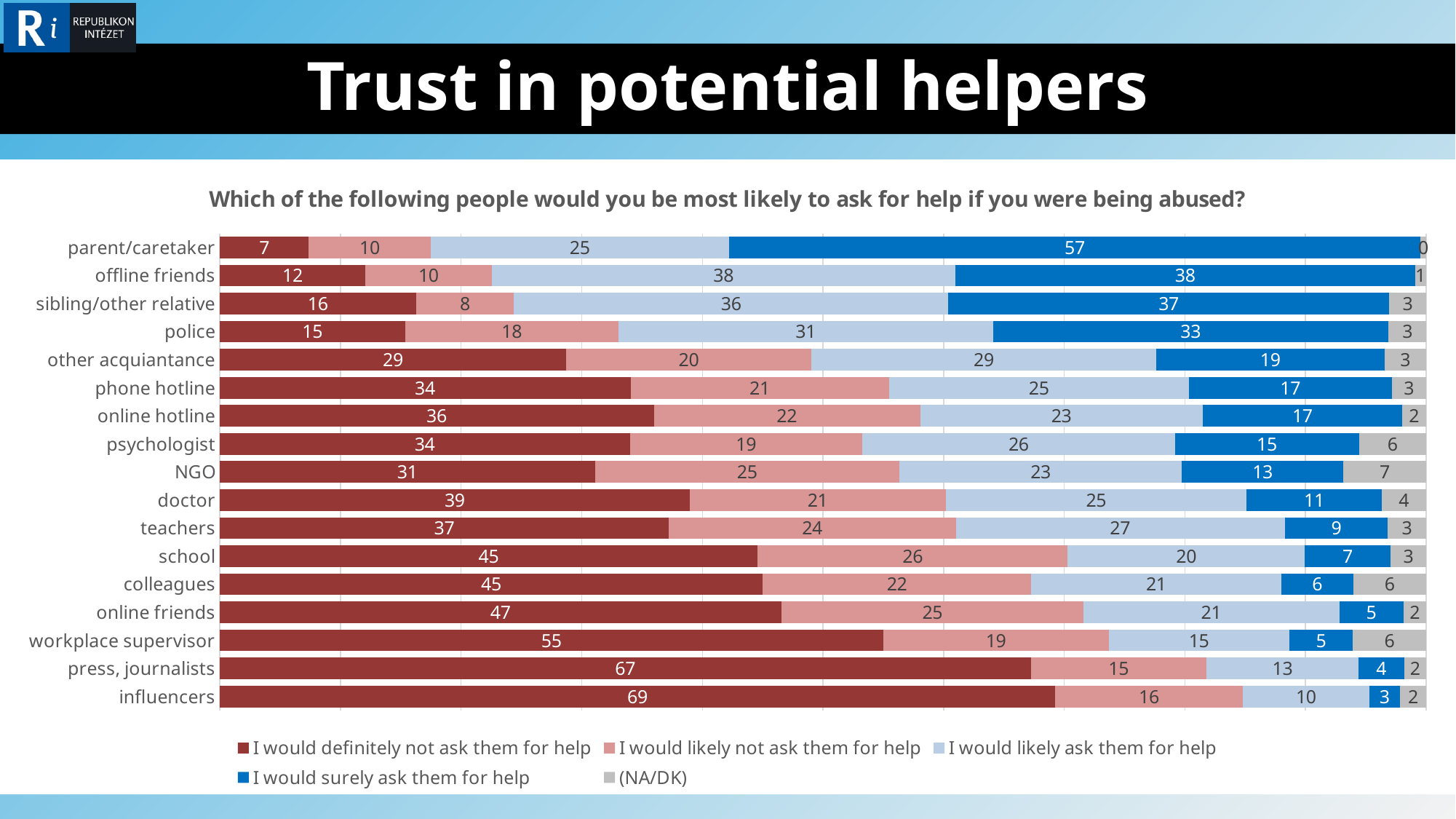
What is the (NA/DK) value for NGO? 7 What is the total of the stacked bar for press, journalists? 101 What is the difference between the 'I would surely ask them for help' values for parent/caretaker and police? 24 What type of chart is shown on the slide? stacked bar chart How many categories (potential helpers) are shown in the chart? 17 What is the value for 'I would likely ask them for help' for offline friends? 38 What is the value for 'I would definitely not ask them for help' for influencers? 69 What is the value for 'I would surely ask them for help' for parent/caretaker? 57 Which is larger: the 'I would definitely not ask them for help' value for doctor or for teachers? doctor Which category has the highest value for 'I would definitely not ask them for help'? influencers How many series does the legend list? 5 Which category has the lowest value for 'I would surely ask them for help'? influencers